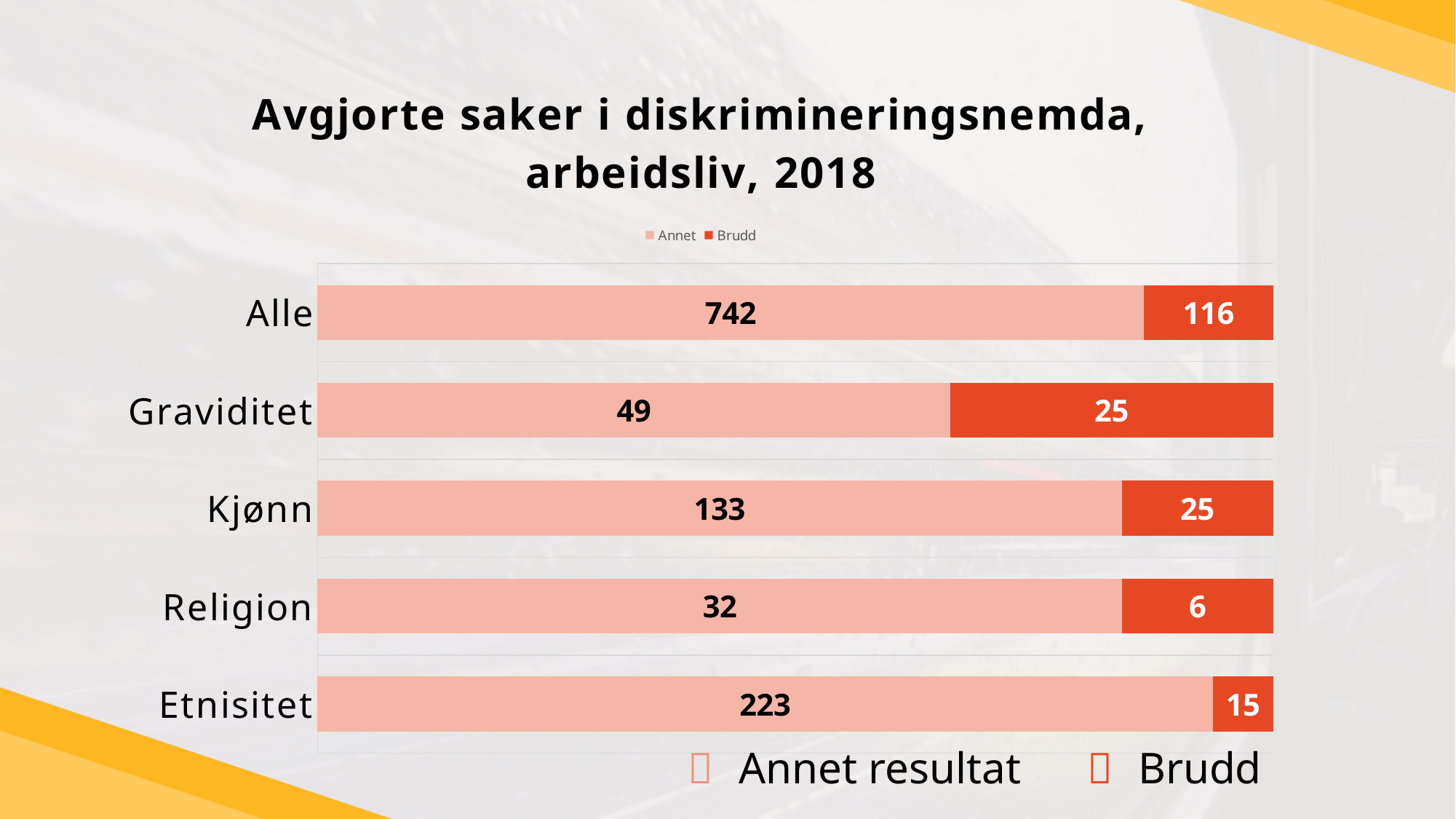
What is the total of the stacked bar for Kjønn? 158 What is the difference between the Annet values for Kjønn and Graviditet? 84 What is the Brudd value for Religion? 6 Which category has the highest Brudd value? Alle What is the Annet value for Alle? 742 Which category has the lowest Annet value? Religion What kind of chart is shown on the slide? Stacked bar chart How many series does the legend list? 2 How many categories are shown on the chart? 5 Which is larger, the Brudd value for Etnisitet or the Brudd value for Religion? Etnisitet What is the Brudd value for Graviditet? 25 What is the Annet value for Etnisitet? 223